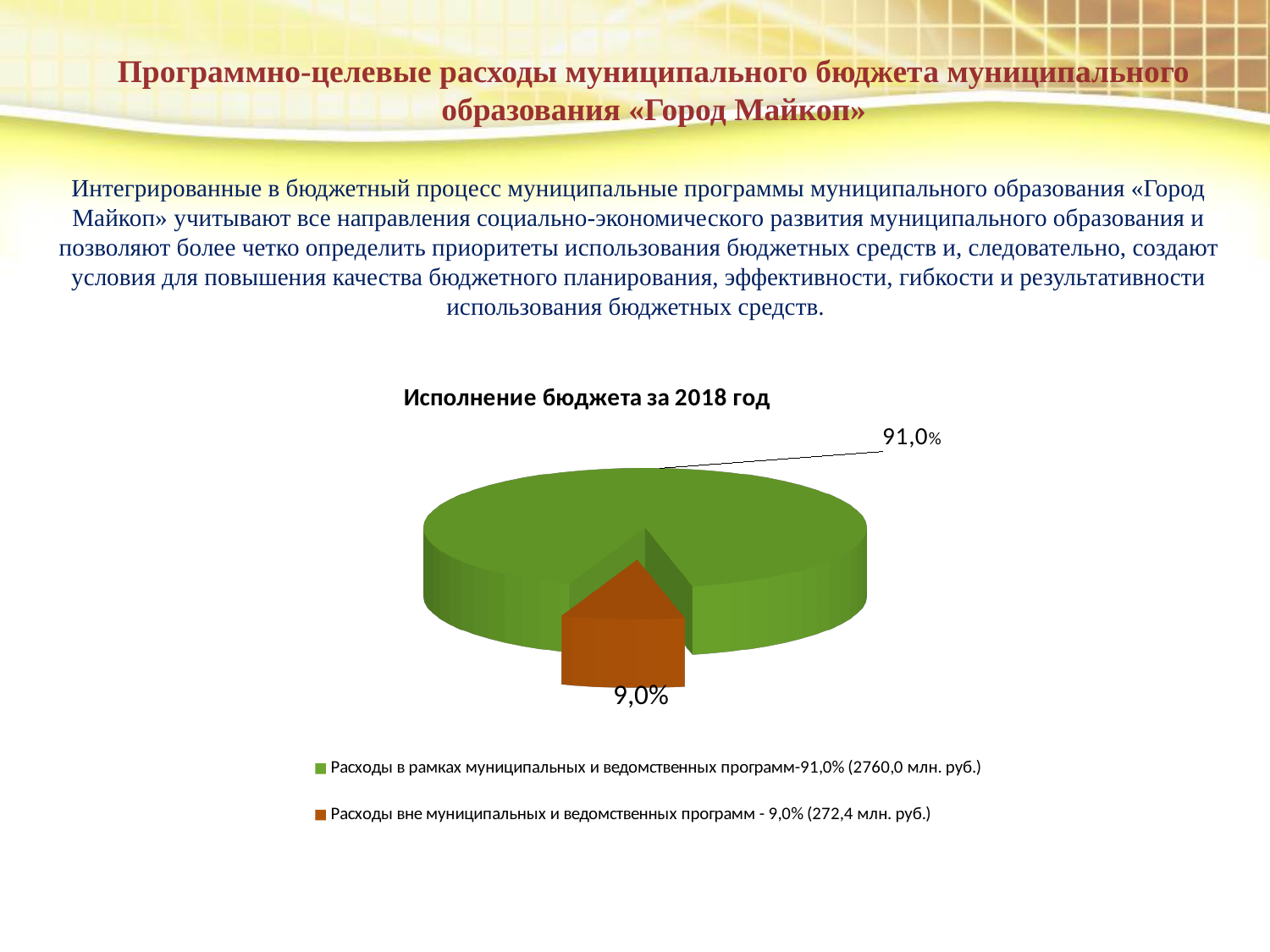
How many entries does the legend list? 2 Which is larger: the share of expenditures within programmes or the share outside programmes? Within programmes (91,0%) Which slice of the pie is the largest? Расходы в рамках муниципальных и ведомственных программ What share of the pie is labelled for expenditures outside municipal and departmental programmes (Расходы вне муниципальных и ведомственных программ)? 9,0% According to the legend, what amount in million roubles corresponds to expenditures outside municipal and departmental programmes? 272,4 млн. руб. Which slice of the pie is the smallest? Расходы вне муниципальных и ведомственных программ What is the title of the chart? Исполнение бюджета за 2018 год How many slices does the pie chart have? 2 What is the difference in percentage points between the two slices of the pie? 82,0% What share of the pie is labelled for expenditures within municipal and departmental programmes (Расходы в рамках муниципальных и ведомственных программ)? 91,0% According to the legend, what amount in million roubles corresponds to expenditures within municipal and departmental programmes? 2760,0 млн. руб. What kind of chart is shown on the slide? Pie chart